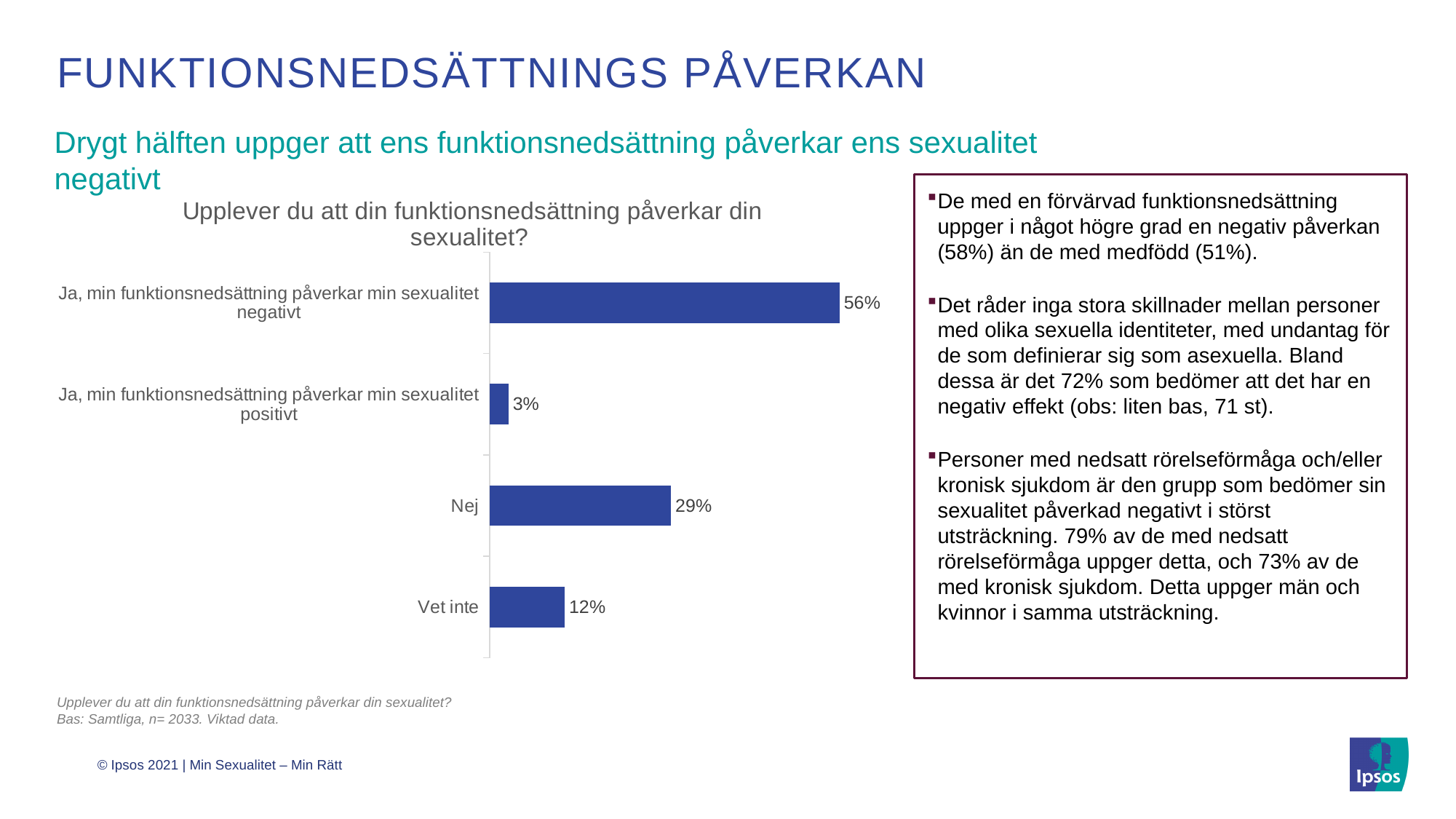
What is the value for "Ja, min funktionsnedsättning påverkar min sexualitet positivt"? 3% What is the title of the chart? Upplever du att din funktionsnedsättning påverkar din sexualitet? How many categories are shown in the chart? 4 What is the value for "Nej"? 29% What is the value for "Ja, min funktionsnedsättning påverkar min sexualitet negativt"? 56% Which category has the lowest value? Ja, min funktionsnedsättning påverkar min sexualitet positivt What is the value for "Vet inte"? 12% Which category has the highest value? Ja, min funktionsnedsättning påverkar min sexualitet negativt Which is larger: the value for "Nej" or the value for "Vet inte"? Nej What kind of chart is shown on the slide? Bar chart What is the difference between the value for "Ja, min funktionsnedsättning påverkar min sexualitet negativt" and the value for "Nej"? 27% What is the difference between the value for "Nej" and the value for "Vet inte"? 17%